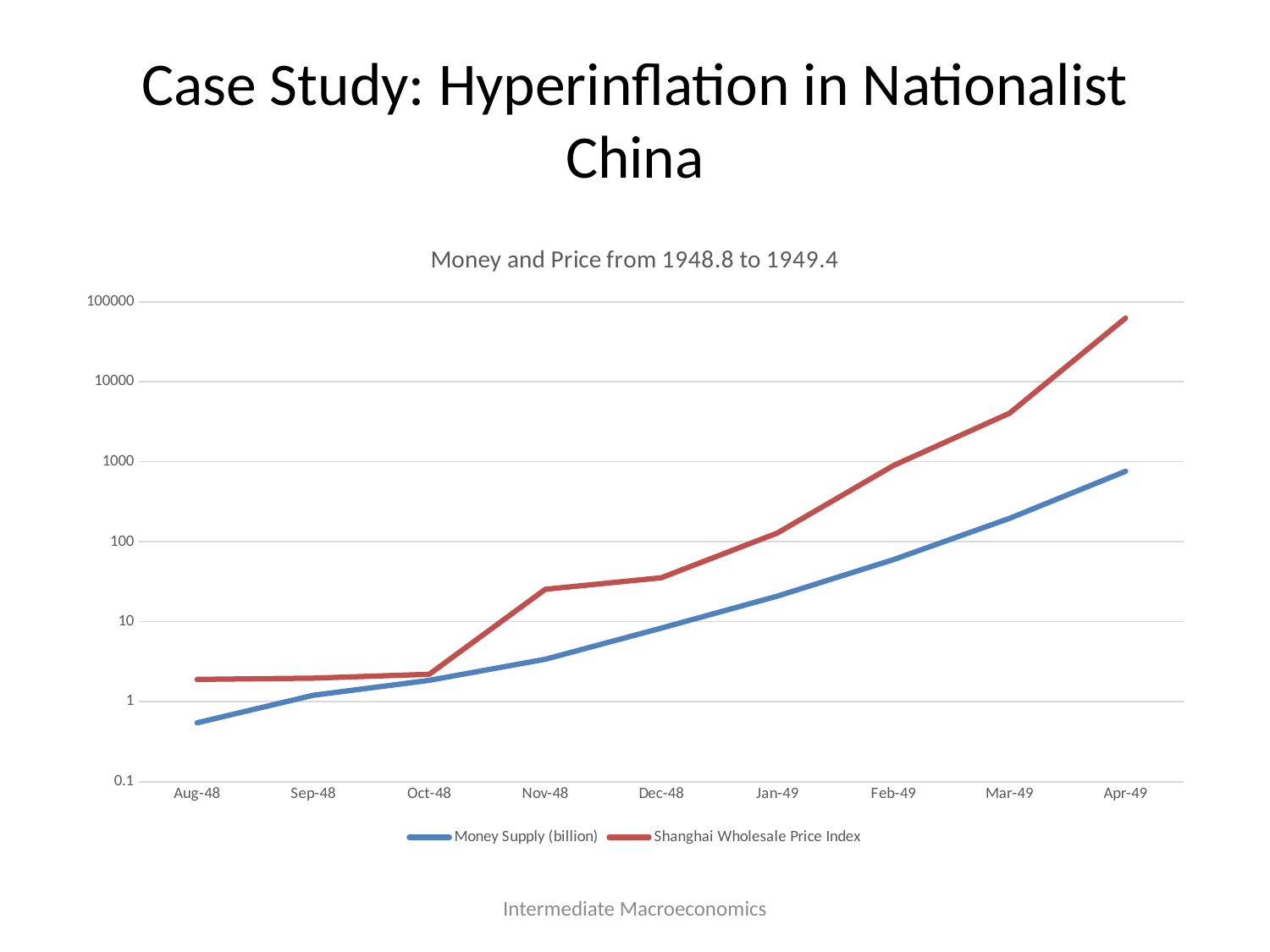
Which colour is used for the Money Supply (billion) line? blue In which month is the Shanghai Wholesale Price Index highest? Apr-49 In which month is the Money Supply (billion) lowest? Aug-48 What kind of chart is shown on the slide? line chart What is the title of the chart? Money and Price from 1948.8 to 1949.4 Is the value for Money Supply (billion) in Aug-48 greater or less than 1? less Is the value for the Shanghai Wholesale Price Index in Apr-49 greater or less than 10000? greater Do the values of the Shanghai Wholesale Price Index rise or fall from Aug-48 to Apr-49? rise In Apr-49, which is larger: the Money Supply (billion) or the Shanghai Wholesale Price Index? Shanghai Wholesale Price Index How many months are plotted along the x axis? 9 Is the value for Money Supply (billion) in Apr-49 greater or less than 1000? less How many series does the legend list? 2